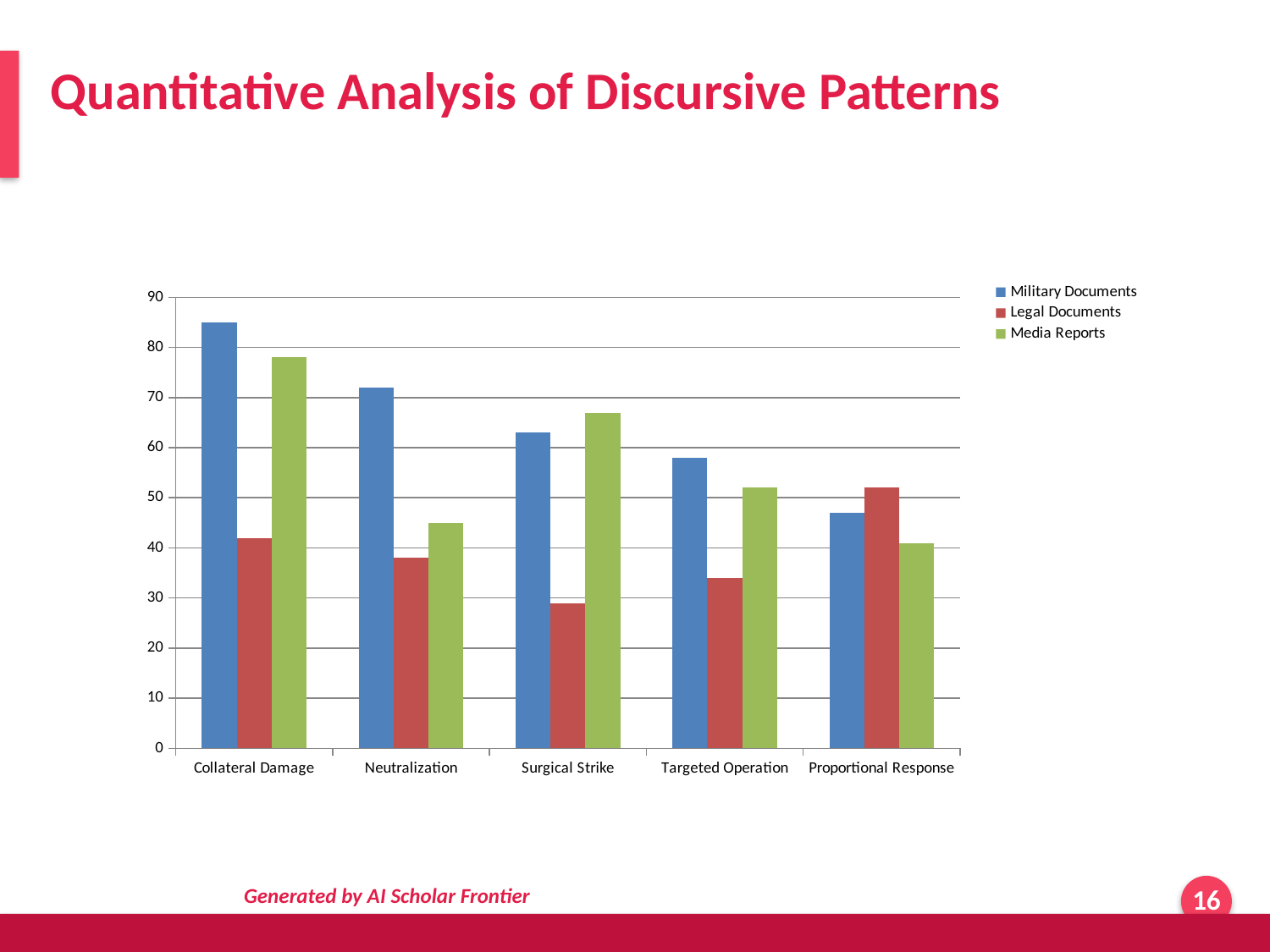
Is the Military Documents value for Collateral Damage greater or less than 80? greater Which series is shown in green? Media Reports Which category has the lowest Media Reports value? Proportional Response Which category has the lowest Legal Documents value? Surgical Strike What kind of chart is shown on the slide? bar chart How many categories are shown on the x axis? 5 Do the Military Documents values rise or fall from Collateral Damage to Proportional Response? fall Is the Media Reports value for Neutralization greater or less than 50? less For Proportional Response, which is larger: Military Documents or Legal Documents? Legal Documents Which category has the highest Military Documents value? Collateral Damage How many series does the legend list? 3